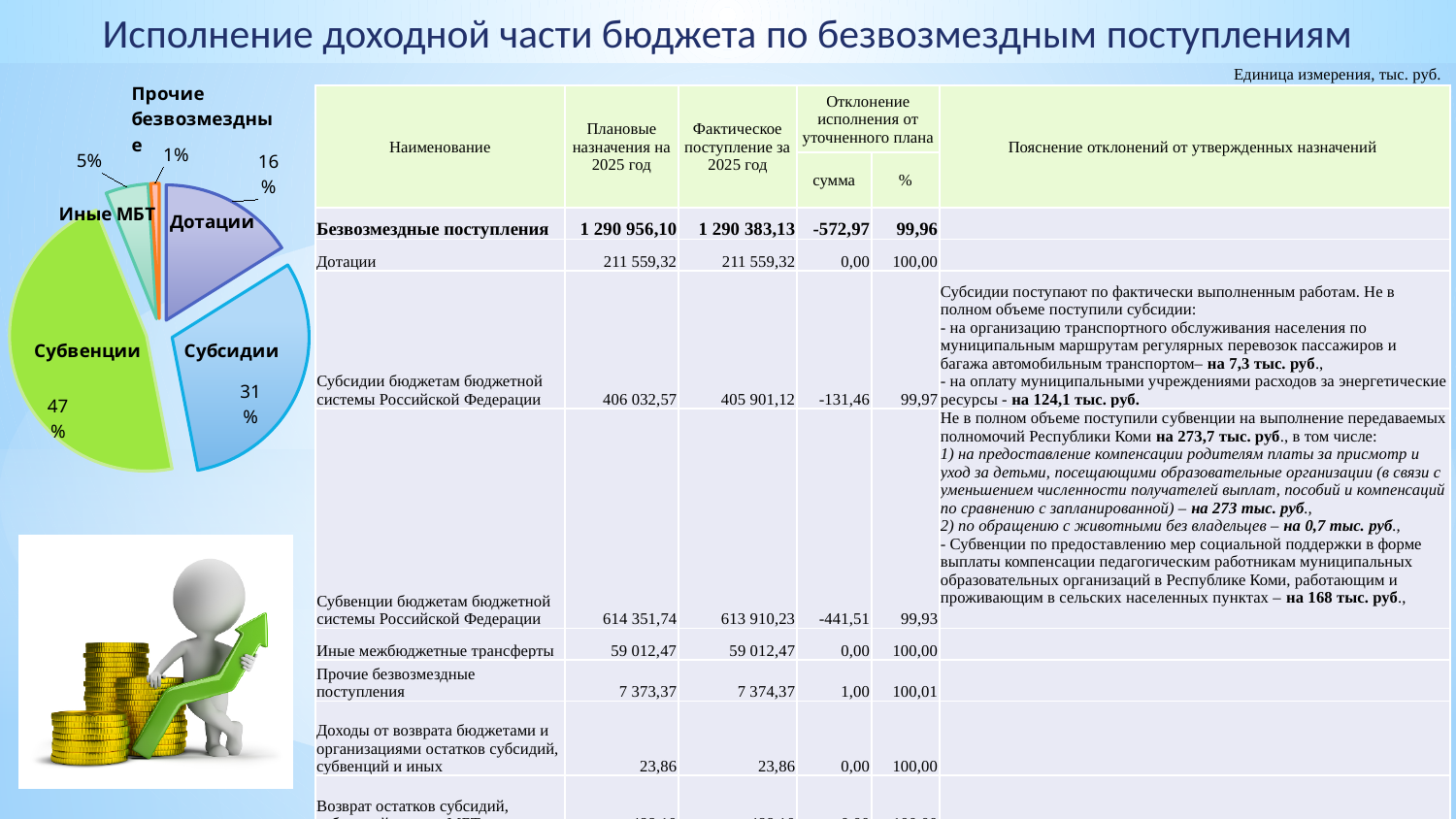
What is the difference in percentage points between the Дотации and Иные МБТ slices of the pie chart? 11 What share of the pie chart does Иные МБТ have? 5% What share of the pie chart does Субсидии have? 31% In the pie chart, which is larger: Субсидии or Дотации? Субсидии How many slices does the pie chart have? 5 Which slice of the pie chart is the largest? Субвенции What share of the pie chart does Прочие безвозмездные have? 1% Which slice of the pie chart is the smallest? Прочие безвозмездные What kind of chart is shown on the left of the slide? pie chart What is the difference in percentage points between the Субвенции and Субсидии slices of the pie chart? 16